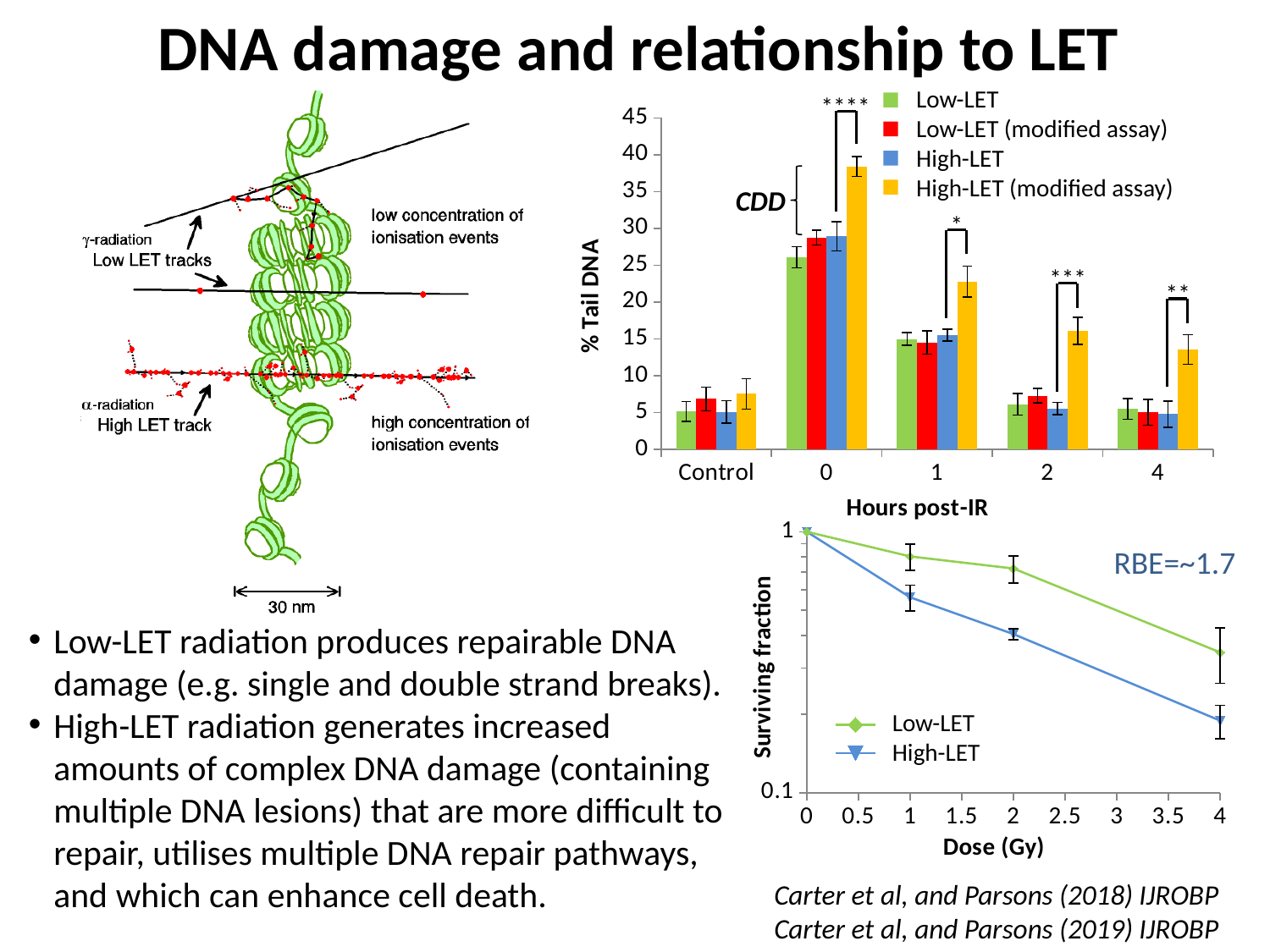
In the bar chart of % Tail DNA, how many categories are shown on the x axis? 5 In the Surviving fraction chart, how many series does the legend list? 2 What is the x-axis title of the bar chart of % Tail DNA? Hours post-IR In the bar chart of % Tail DNA, is the value for High-LET (modified assay) at 4 hours post-IR greater or less than 10? greater In the bar chart of % Tail DNA, how many series does the legend list? 4 What kind of chart is the Surviving fraction chart at the bottom right? Line chart In the bar chart of % Tail DNA, is the Low-LET value for the Control category greater or less than 10? less In the Surviving fraction chart, does the High-LET series rise or fall as dose increases? Fall In the bar chart of % Tail DNA, which is larger at 2 hours post-IR: High-LET or High-LET (modified assay)? High-LET (modified assay) In the bar chart of % Tail DNA, which series has the tallest bar at 0 hours post-IR? High-LET (modified assay) In the bar chart of % Tail DNA, is the value for High-LET (modified assay) at 1 hour post-IR greater or less than 20? greater